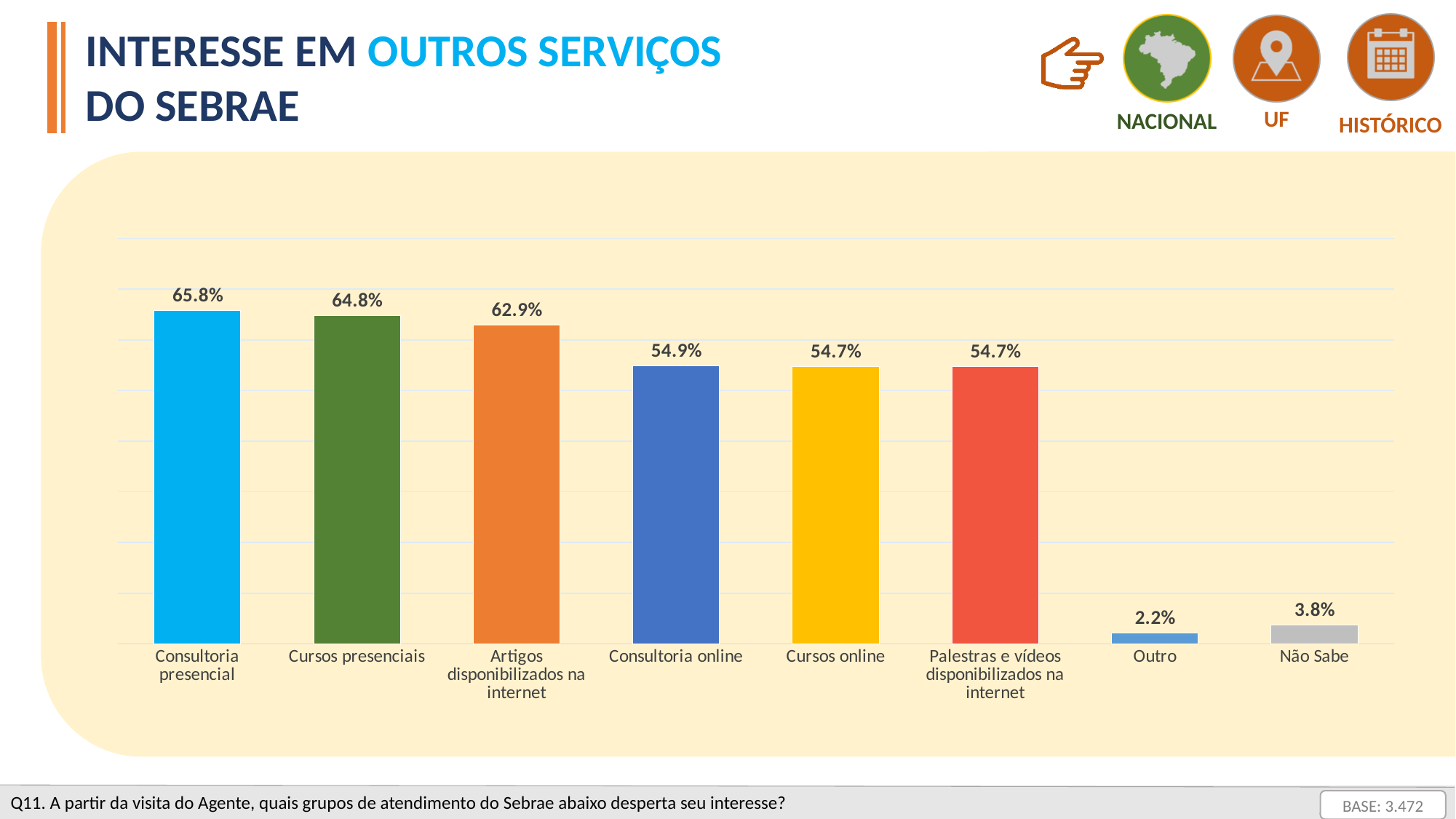
What is the value for Não Sabe? 3.8% What is the value for Palestras e vídeos disponibilizados na internet? 54.7% Which is larger, Cursos presenciais or Artigos disponibilizados na internet? Cursos presenciais How many categories are shown in the chart? 8 What kind of chart is shown on the slide? Bar chart What colour is the bar for Cursos online? Yellow What is the difference between Não Sabe and Outro? 1.6% Which category has the lowest value? Outro What is the value for Consultoria presencial? 65.8% Which category has the highest value? Consultoria presencial What is the value for Cursos online? 54.7% What is the difference between Consultoria presencial and Consultoria online? 10.9%